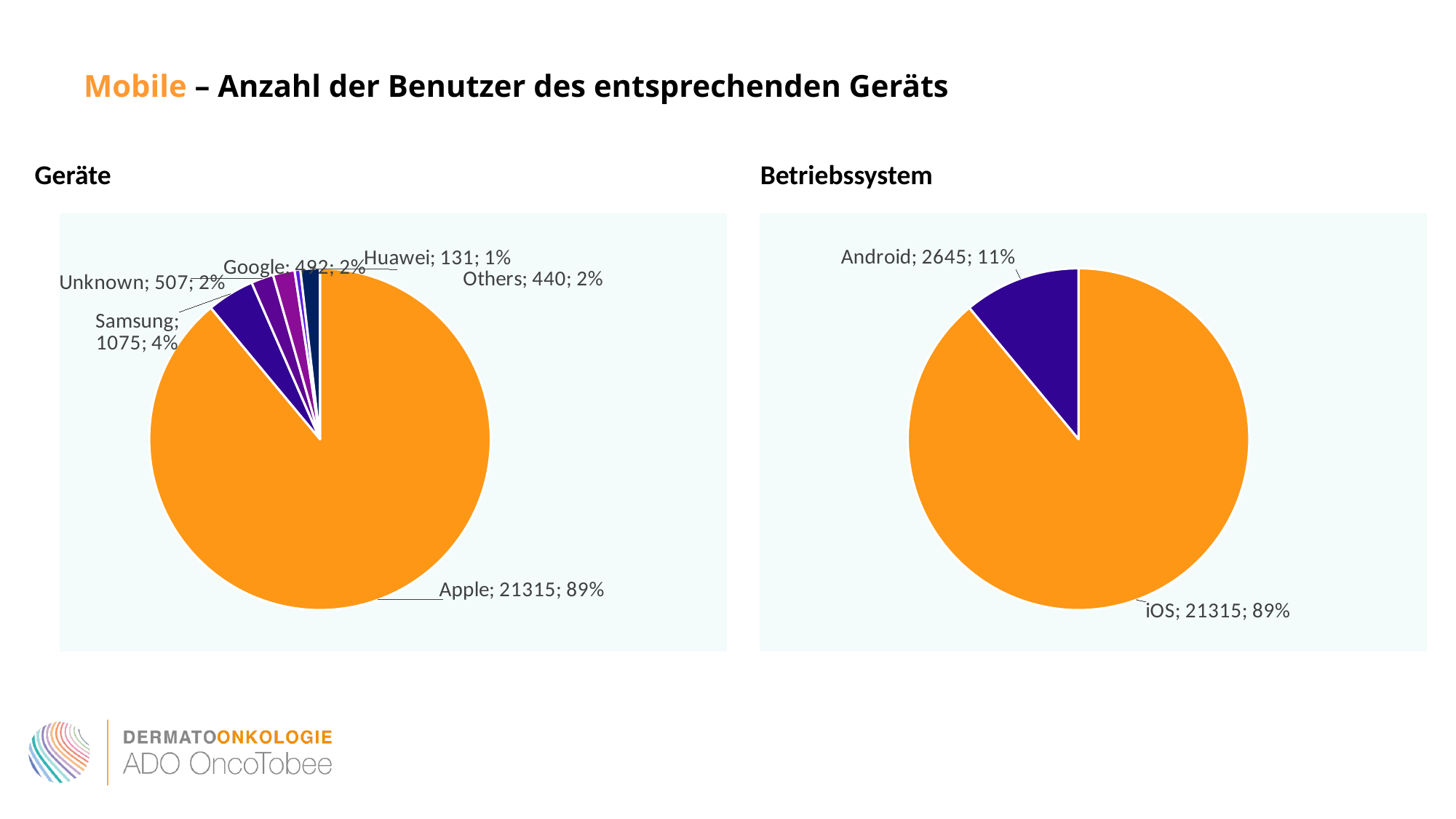
In the Geräte chart, which device category has the smallest number of users? Huawei In the Geräte chart, which device category has the largest number of users? Apple What type of chart is used for the Betriebssystem data? Pie chart In the Betriebssystem chart, what share of the pie does Android hold? 11% In the Geräte chart, what is the difference in users between Samsung and Google? 583 In the Betriebssystem chart, how many users are shown for Android? 2645 In the Betriebssystem chart, what is the difference in users between iOS and Android? 18670 How many slices does the Geräte pie chart have? 6 In the Geräte chart, how many users are shown for Apple? 21315 In the Geräte chart, which has more users, Unknown or Others? Unknown In the Geräte chart, how many users are shown for Samsung? 1075 In the Geräte chart, what share of the pie does Apple hold? 89%